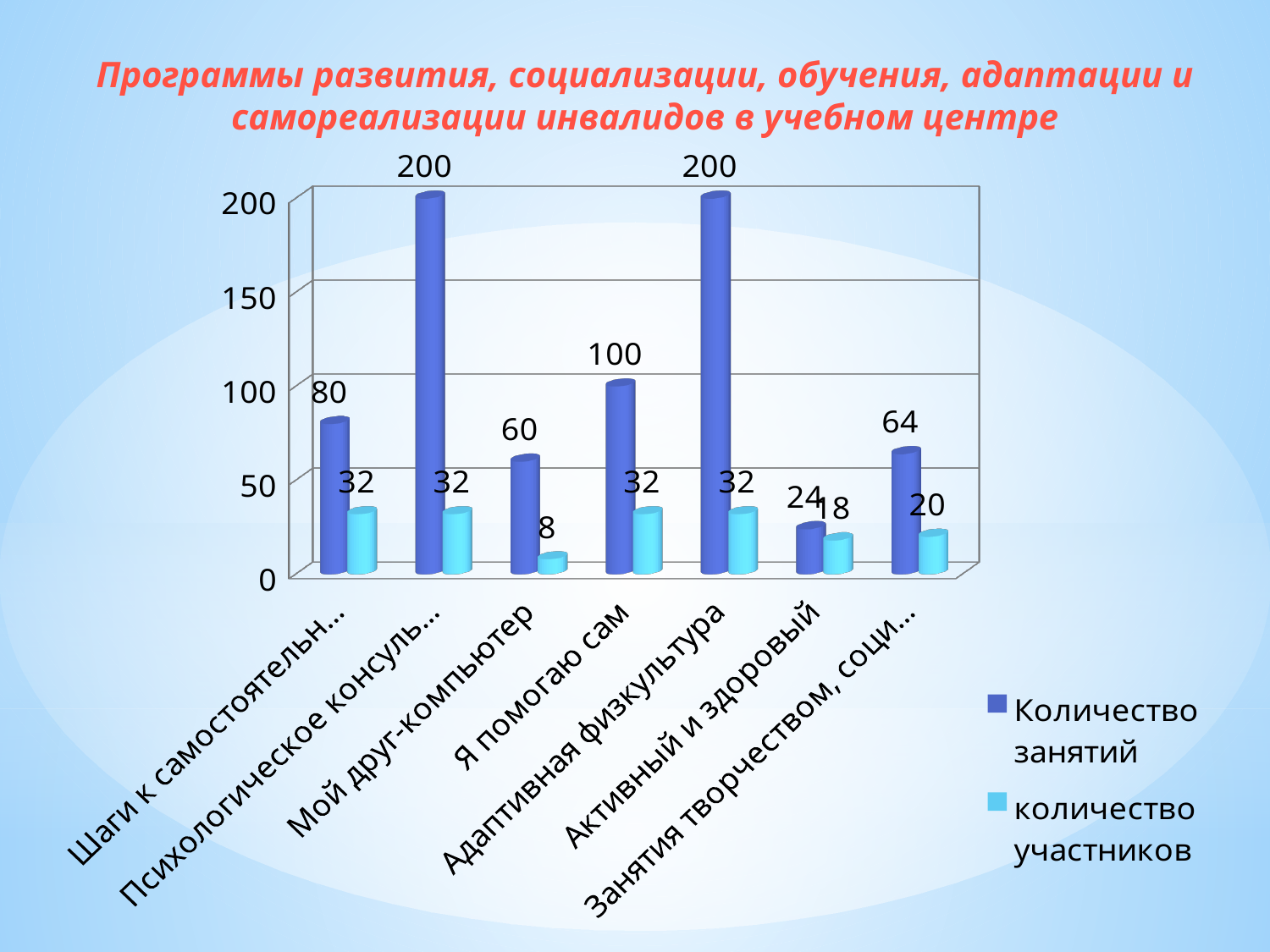
What is the value of "Количество занятий" for "Адаптивная физкультура"? 200 Which is larger: "Количество занятий" for "Мой друг-компьютер" or for "Активный и здоровый"? Мой друг-компьютер What is the difference between "Количество занятий" and "количество участников" for "Я помогаю сам"? 68 What is the value of "количество участников" for "Мой друг-компьютер"? 8 What is the value of "Количество занятий" for "Активный и здоровый"? 24 Which category has the lowest value for "Количество занятий"? Активный и здоровый How many series does the legend list? 2 What is the value of "Количество занятий" for "Я помогаю сам"? 100 What colour are the bars for "количество участников"? Light blue What type of chart is shown on the slide? Bar chart Which category has the lowest value for "количество участников"? Мой друг-компьютер How many categories are shown on the x axis? 7